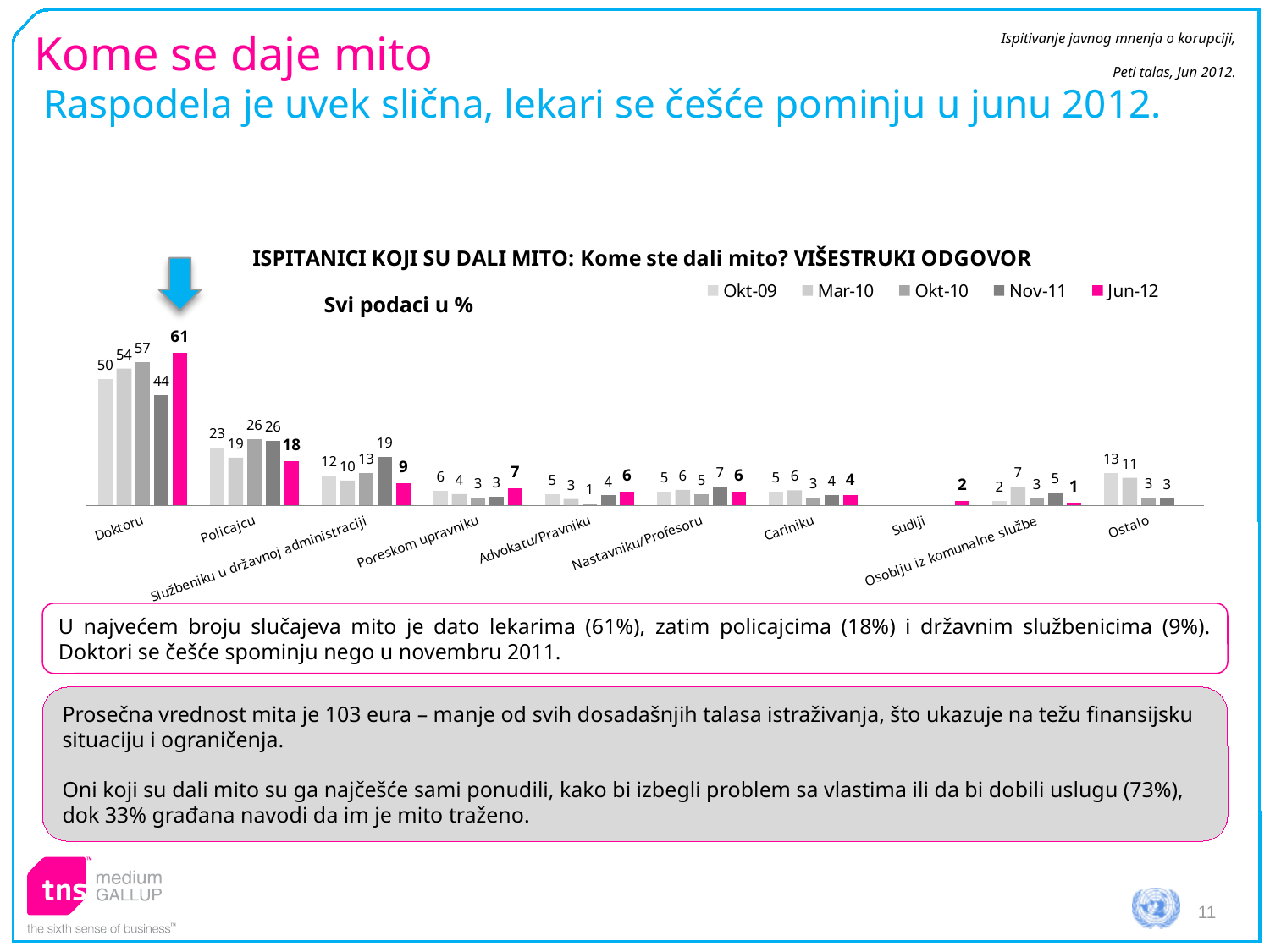
What is the Jun-12 value for Doktoru? 61 How many series does the legend list? 5 What is the difference between the Jun-12 and Nov-11 values for Doktoru? 17 Which category has the highest Jun-12 value? Doktoru What is the Jun-12 value for Sudiji? 2 What is the Nov-11 value for Doktoru? 44 How many categories are shown on the x axis? 10 What kind of chart is shown on the slide? bar chart For Policajcu, which is larger: the Okt-10 value or the Jun-12 value? Okt-10 What colour represents the Jun-12 series in the legend? pink (magenta) What is the Jun-12 value for Policajcu? 18 What is the Nov-11 value for Službeniku u državnoj administraciji? 19